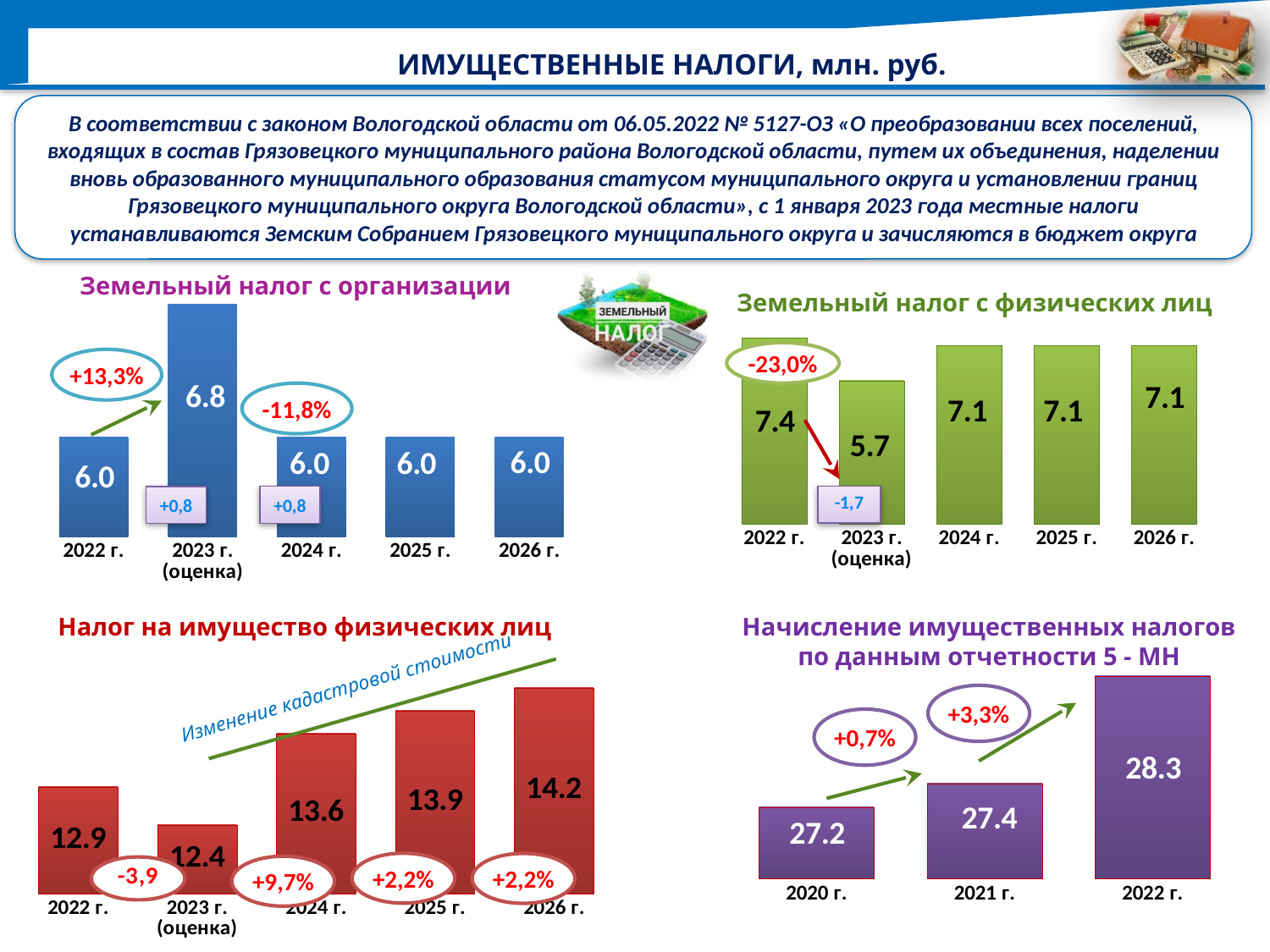
In the chart 'Налог на имущество физических лиц', how many years are shown? 5 In the chart 'Земельный налог с организации', which year has the highest value? 2023 г. (оценка) In the chart 'Земельный налог с физических лиц', what is the difference between the values for 2022 г. and 2023 г. (оценка)? 1.7 In the chart 'Налог на имущество физических лиц', which is larger, the value for 2022 г. or 2023 г. (оценка)? 2022 г. In the chart 'Земельный налог с физических лиц', which year has the lowest value? 2023 г. (оценка) In the chart 'Налог на имущество физических лиц', do the values rise or fall from 2023 г. (оценка) to 2026 г.? rise What type of chart is 'Начисление имущественных налогов по данным отчетности 5 - МН'? bar chart In the chart 'Земельный налог с физических лиц', what is the value for 2022 г.? 7.4 In the chart 'Начисление имущественных налогов по данным отчетности 5 - МН', what is the value for 2022 г.? 28.3 In the chart 'Земельный налог с организации', what is the value for 2023 г. (оценка)? 6.8 In the chart 'Налог на имущество физических лиц', what is the value for 2026 г.? 14.2 In the chart 'Начисление имущественных налогов по данным отчетности 5 - МН', what is the difference between the values for 2022 г. and 2020 г.? 1.1